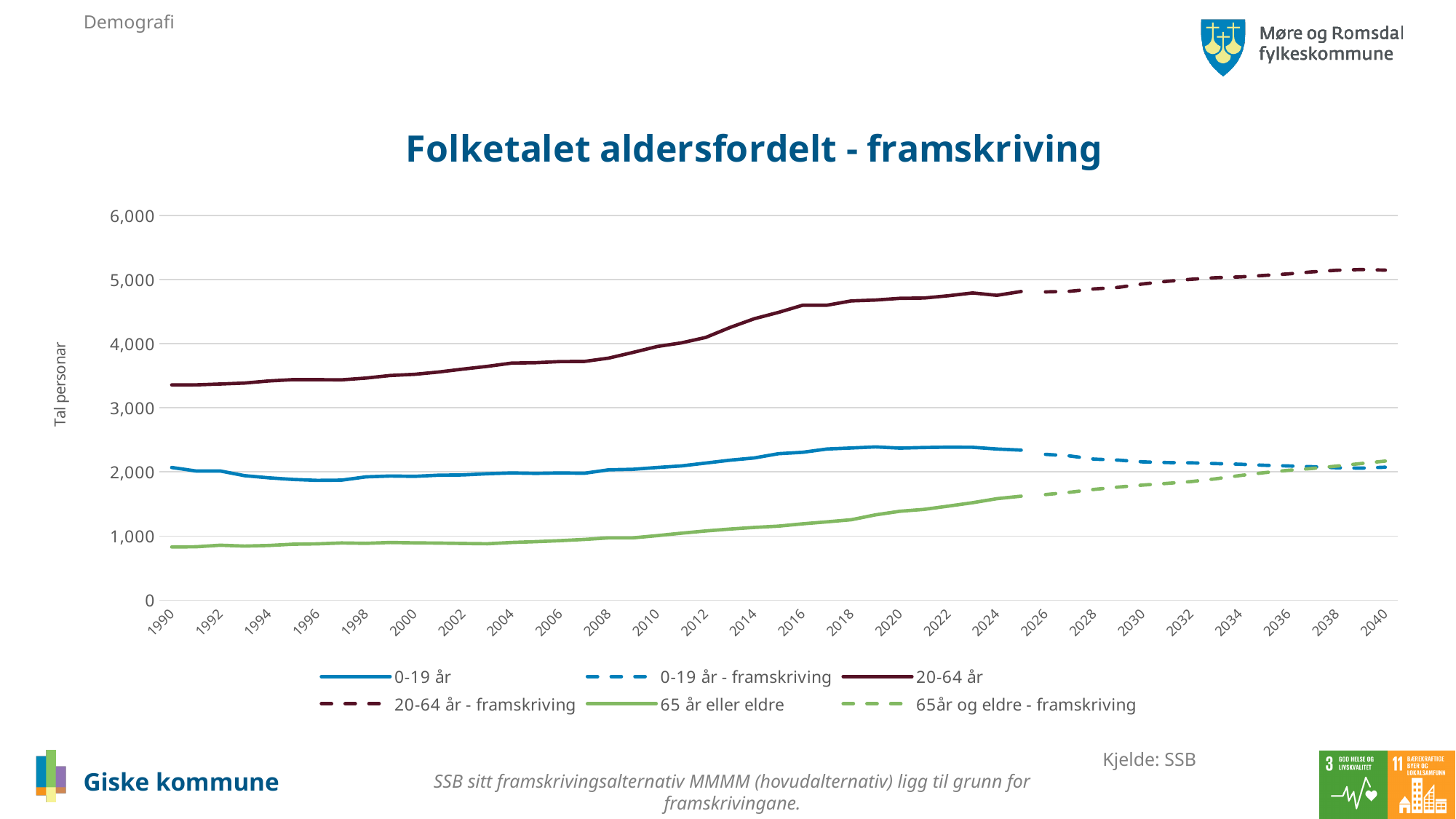
In 2010, which is larger: 0-19 år or 65 år eller eldre? 0-19 år What is the title of the chart? Folketalet aldersfordelt - framskriving Is the value for 20-64 år in 2016 greater or less than 4,000? greater Is the value for 20-64 år - framskriving in 2040 greater or less than 5,000? greater Is the value for 65 år eller eldre in 1990 greater or less than 1,000? less Does the 20-64 år series rise or fall from 1990 to 2024? rise What is the label on the vertical axis? Tal personar How many series does the legend list? 6 Does the 65 år eller eldre series rise or fall from 2010 to 2024? rise Which series has the lowest value in 1990? 65 år eller eldre What kind of chart is shown on the slide? line chart